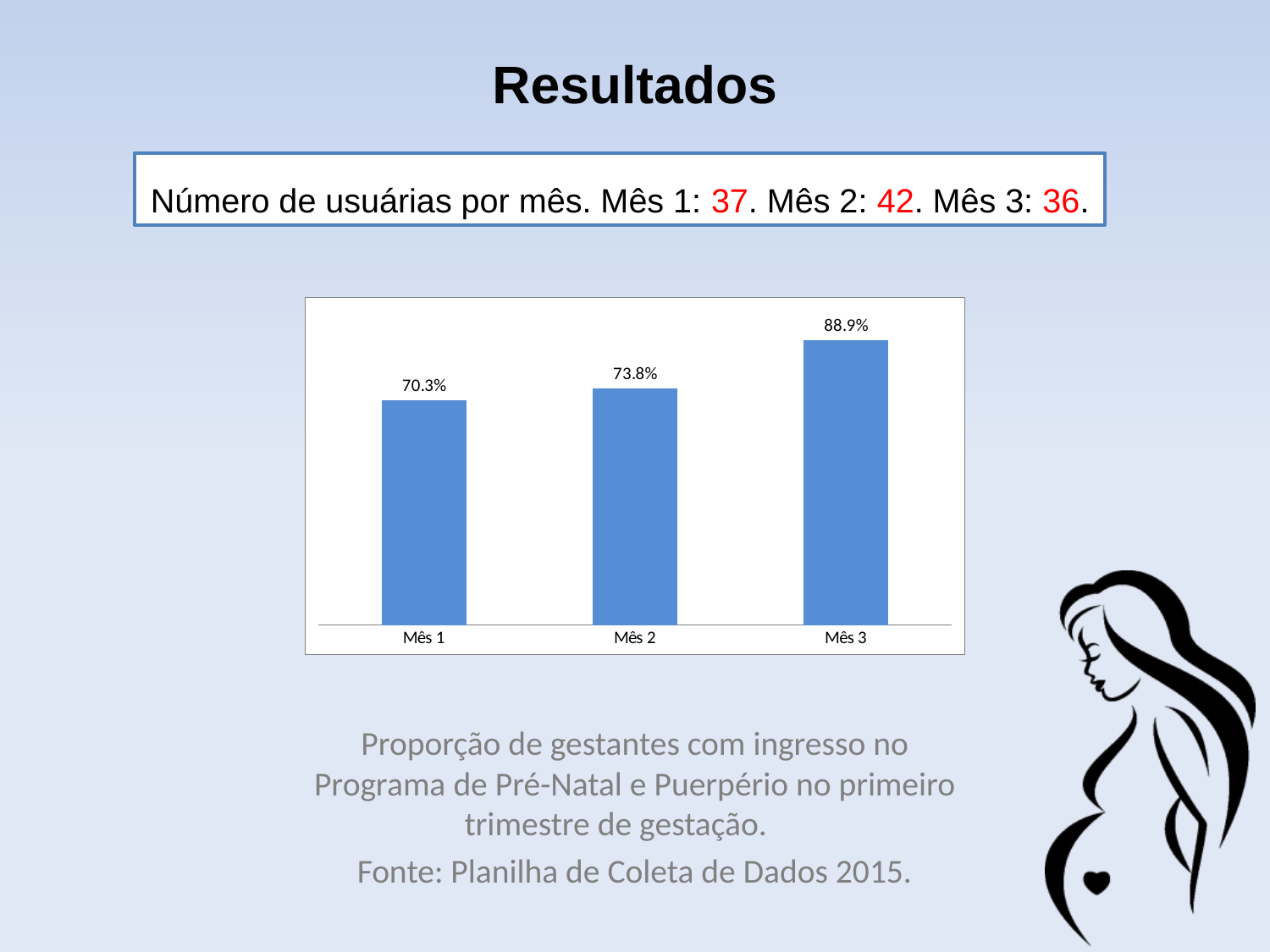
What colour are the bars in the chart? Blue What is the difference between the values for Mês 3 and Mês 1? 18.6% Which month has the lowest value? Mês 1 Which month has the highest value? Mês 3 What kind of chart is shown on the slide? Bar chart What is the value for Mês 3? 88.9% How many categories are shown on the x axis of the chart? 3 What is the difference between the values for Mês 2 and Mês 1? 3.5% Which is larger, the value for Mês 2 or the value for Mês 3? Mês 3 What is the value for Mês 2? 73.8% Do the values rise or fall from Mês 1 to Mês 3? Rise What is the value for Mês 1? 70.3%